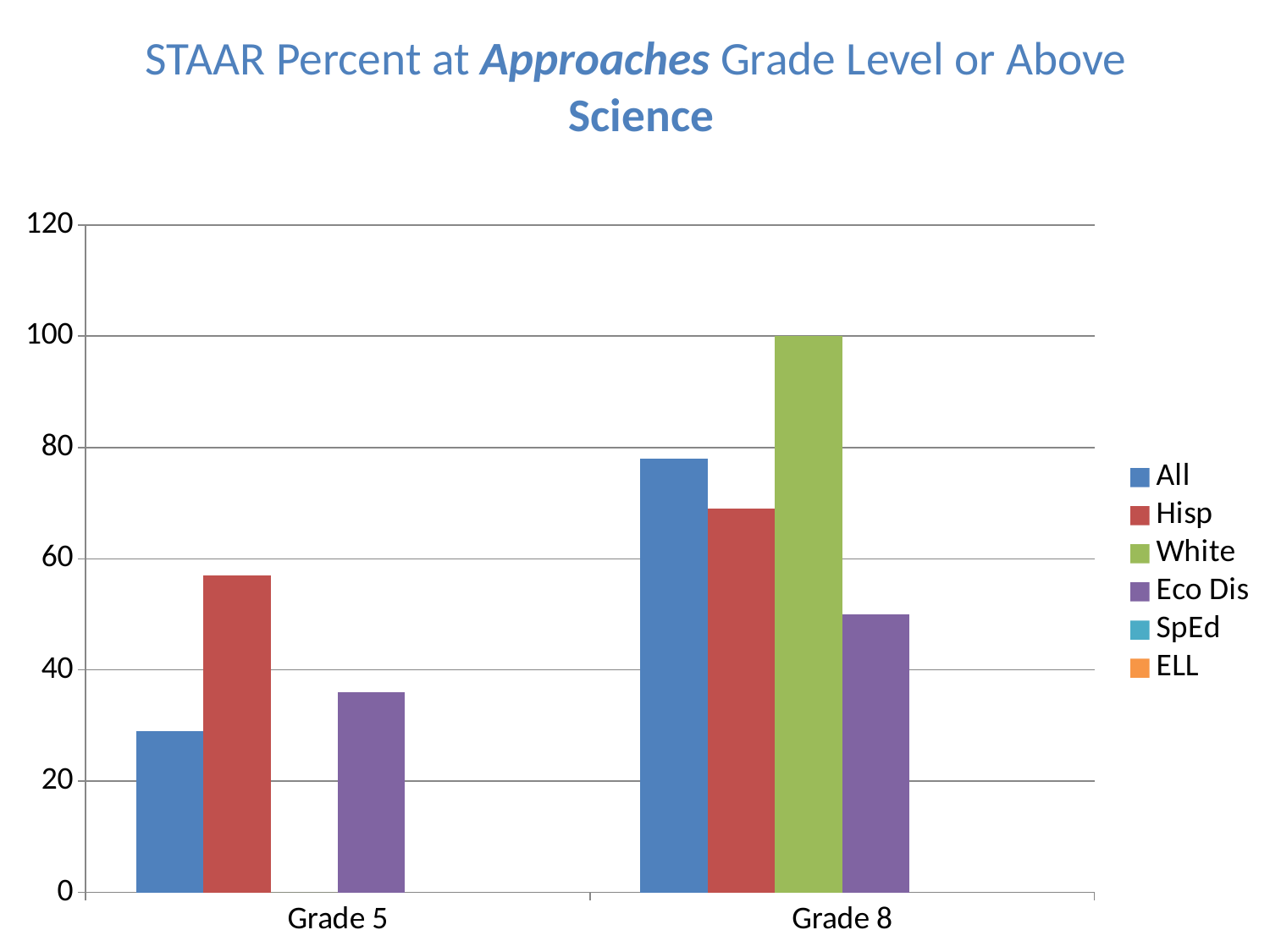
Does the value for Eco Dis rise or fall from Grade 5 to Grade 8? rise What is the value for White in Grade 8? 100 How many series does the legend list? 6 Which subject does the chart title say the STAAR results are for? Science Which series has the lowest value among the plotted bars in Grade 5? All Is the value for All in Grade 5 greater or less than 40? less Is the value for All in Grade 8 greater or less than 60? greater Which series has the highest value in Grade 8? White Which series has the highest value in Grade 5? Hisp What kind of chart is shown on the slide? bar chart Which is larger: Hisp in Grade 5 or Hisp in Grade 8? Hisp in Grade 8 How many grade categories are shown on the x axis? 2